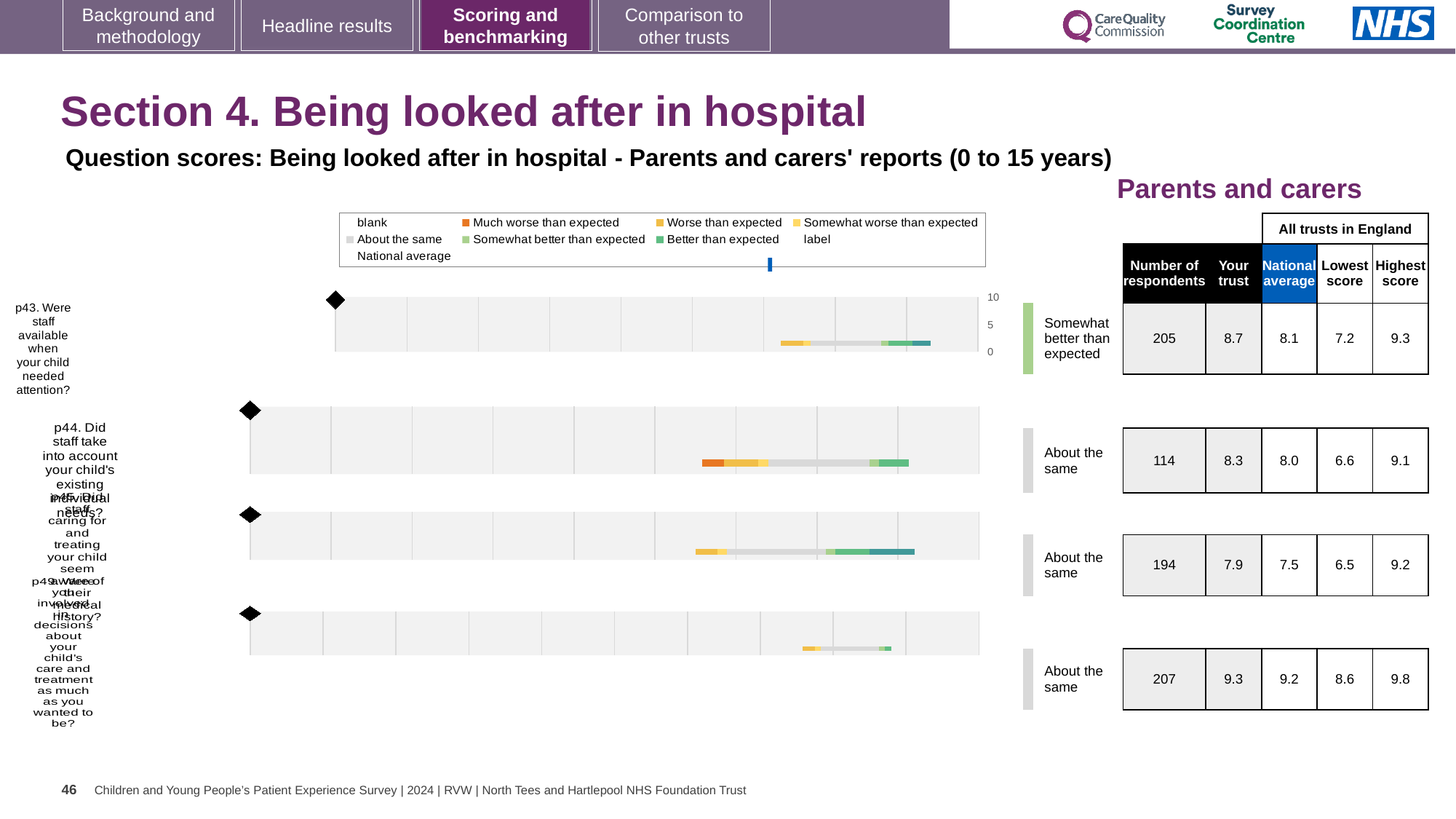
What is the lowest score across all trusts in England for the third row of the chart? 6.5 Which row of the chart has the highest 'Your trust' score? The fourth (bottom) row, 9.3 What benchmark category is given for question p43 (Were staff available when your child needed attention?)? Somewhat better than expected For question p43, which is larger: the 'Your trust' score or the national average? Your trust What is the national average score for question p43 (Were staff available when your child needed attention?)? 8.1 Which row of the chart has the lowest 'Your trust' score? The third row, 7.9 What is the 'Your trust' score for question p43 (Were staff available when your child needed attention?)? 8.7 What is the highest score across all trusts in England for the fourth (bottom) row of the chart? 9.8 How many respondents are shown for question p43 (Were staff available when your child needed attention?)? 205 What kind of chart is used to show the question scores? Bar chart How many questions (rows) are plotted on the chart? 4 What is the difference between the 'Your trust' score and the national average for question p43? 0.6